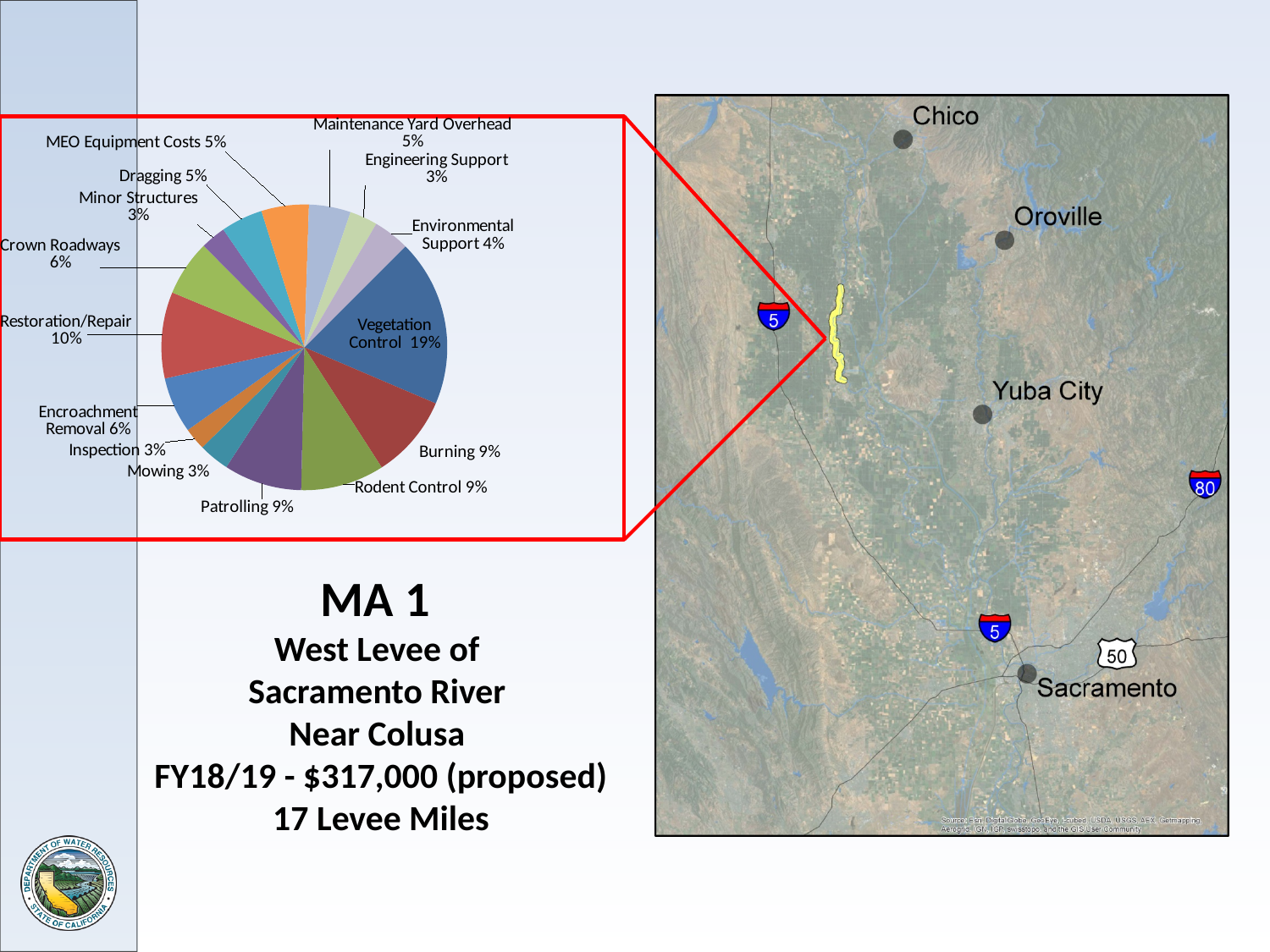
What share of the pie does Vegetation Control represent? 19% What percentage is shown for Restoration/Repair? 10% What percentage is shown for Environmental Support? 4% What percentage is shown for Encroachment Removal? 6% What type of chart is shown on the slide? pie chart What is the difference in percentage points between Vegetation Control and Restoration/Repair? 9 What percentage is shown for Maintenance Yard Overhead? 5% Which is larger, the share for Burning or the share for Mowing? Burning How many slices does the pie chart have? 15 Which category has the largest slice of the pie? Vegetation Control What is the difference in percentage points between Crown Roadways and Inspection? 3 What percentage is shown for Patrolling? 9%